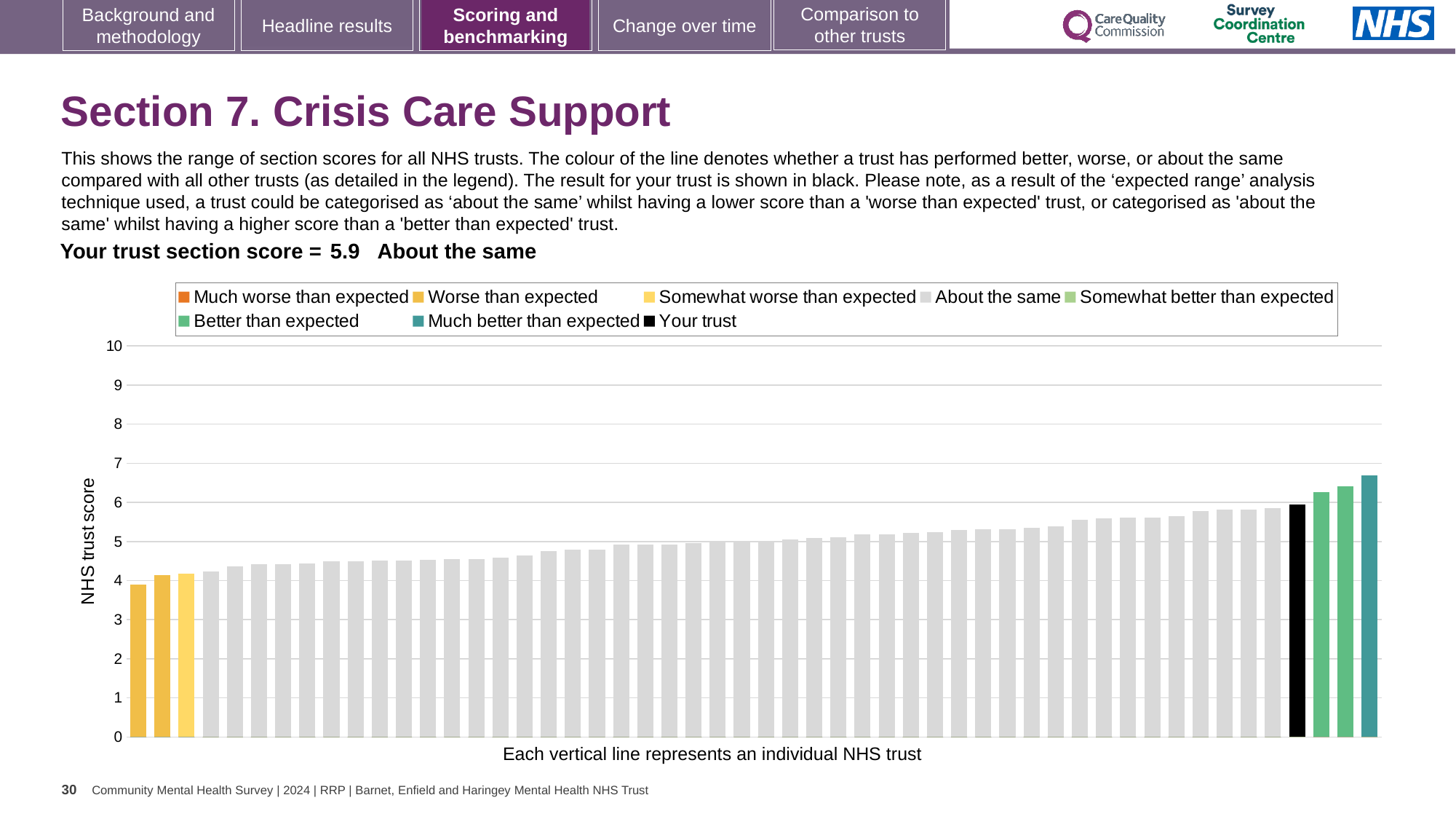
Do the bar values rise or fall from left to right along the x axis? rise What is the label on the y axis of the chart? NHS trust score How many bars are coloured as 'Worse than expected' (gold)? 2 What is the section score for your trust shown on the slide? 5.9 Is the value of the black 'Your trust' bar greater or less than 5? greater What colour is used for the 'Your trust' bar? black Which legend category does the tallest bar belong to? Much better than expected How many entries does the chart legend list? 8 Is the value of the leftmost bar greater or less than 4? less Is the value of the tallest bar (the rightmost, teal bar) greater or less than 7? less How many bars are coloured as 'Better than expected' (green)? 2 What kind of chart is shown on the slide? bar chart